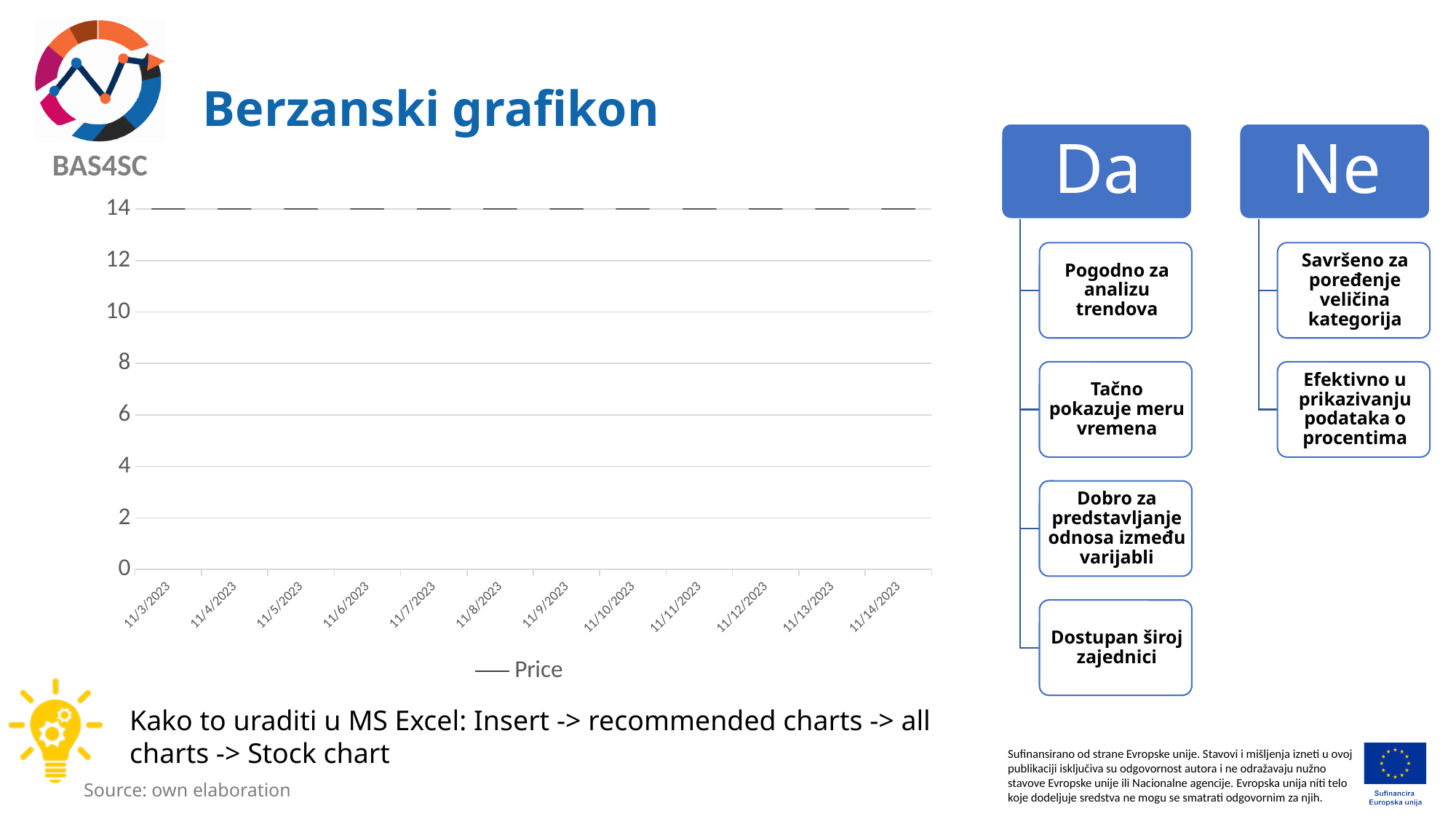
What is the lowest tick value shown on the y axis of the chart? 0 What kind of chart is shown on the slide? stock chart How many series does the chart legend list? 1 Is the Price value for 11/3/2023 greater or less than 10? greater How many dates are shown on the x axis of the chart? 12 What series name does the chart legend show? Price What is the highest tick value shown on the y axis of the chart? 14 Is the Price value for 11/14/2023 greater or less than 8? greater What is the title of the slide containing the chart? Berzanski grafikon What is the last date shown on the x axis of the chart? 11/14/2023 What is the first date shown on the x axis of the chart? 11/3/2023